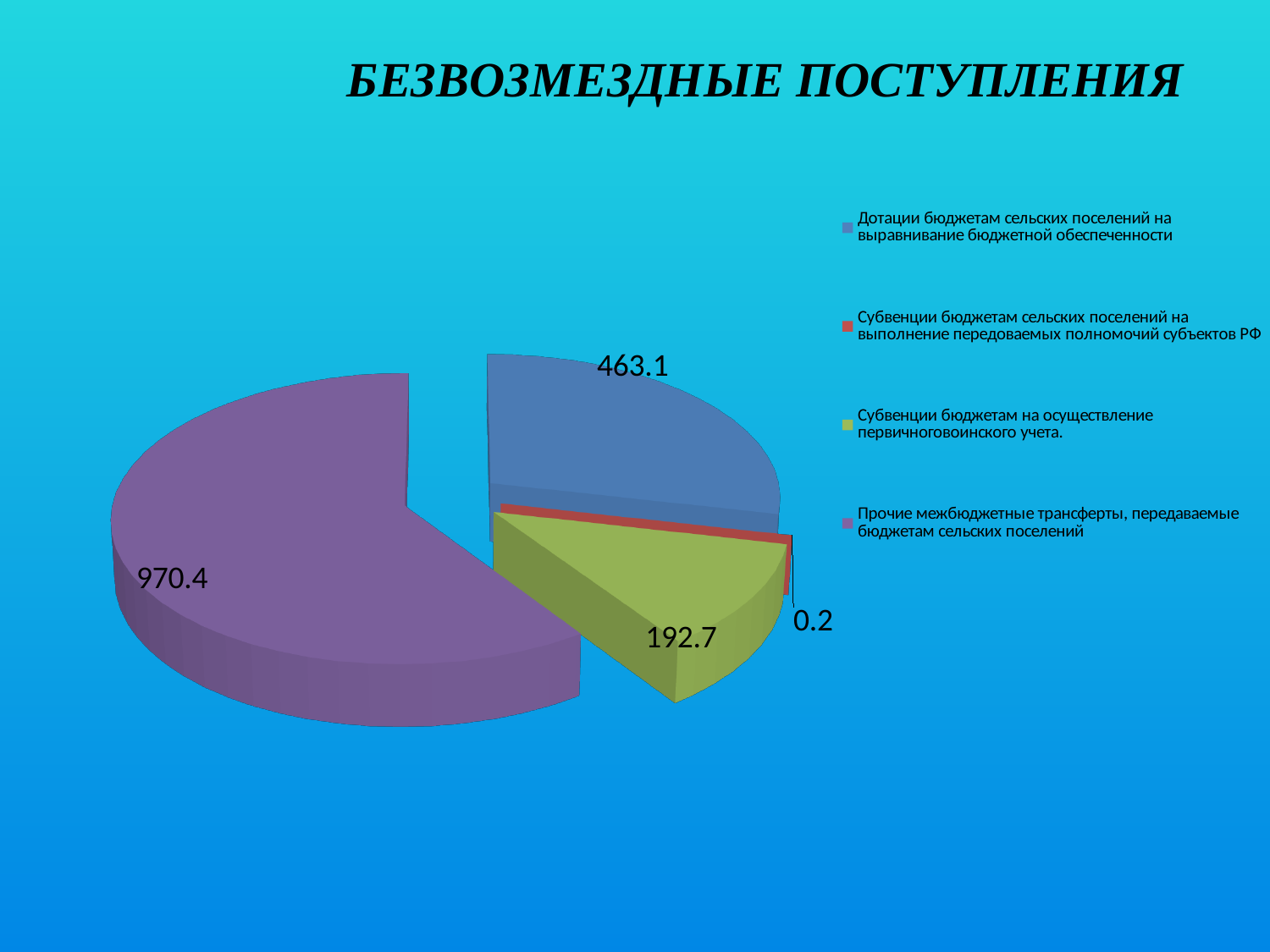
What is the value for "Субвенции бюджетам сельских поселений на выполнение передаваемых полномочий субъектов РФ"? 0.2 How many categories does the pie chart have? 4 What is the difference between the value for "Прочие межбюджетные трансферты" and the value for "Дотации бюджетам сельских поселений"? 507.3 What kind of chart is shown on the slide? Pie chart What is the value for "Субвенции бюджетам на осуществление первичного воинского учета"? 192.7 Which category has the smallest slice of the pie? Субвенции бюджетам сельских поселений на выполнение передаваемых полномочий субъектов РФ What is the value for "Дотации бюджетам сельских поселений на выравнивание бюджетной обеспеченности"? 463.1 What is the difference between the value for "Дотации бюджетам сельских поселений" and the value for "Субвенции бюджетам на осуществление первичного воинского учета"? 270.4 What is the value for "Прочие межбюджетные трансферты, передаваемые бюджетам сельских поселений"? 970.4 Which category has the largest slice of the pie? Прочие межбюджетные трансферты, передаваемые бюджетам сельских поселений Which is larger: the value for "Дотации бюджетам сельских поселений" or the value for "Субвенции бюджетам на осуществление первичного воинского учета"? Дотации бюджетам сельских поселений What is the title of the slide's chart? БЕЗВОЗМЕЗДНЫЕ ПОСТУПЛЕНИЯ